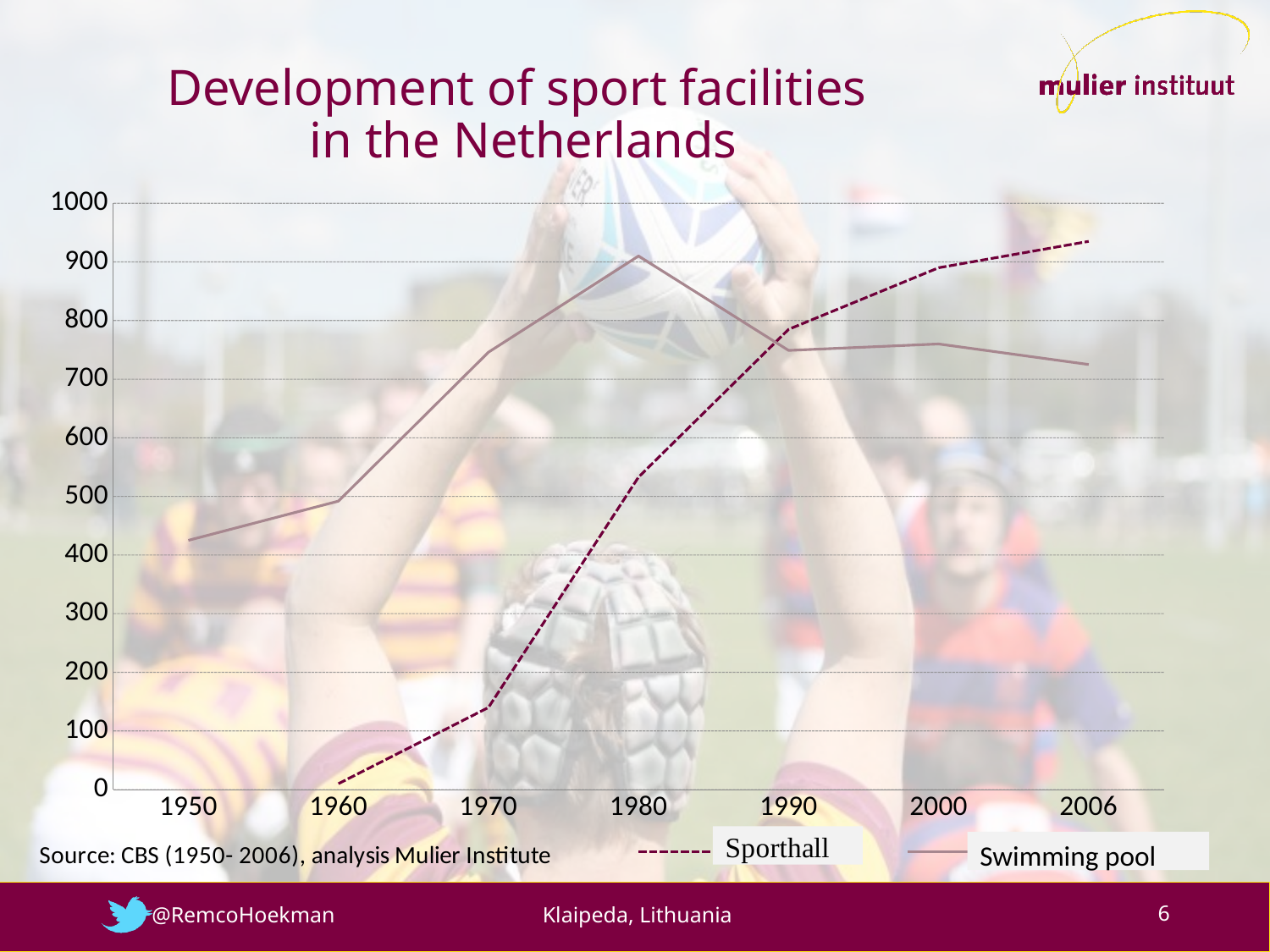
How many series does the legend list? 2 In 2006, which series has the larger value, Sporthall or Swimming pool? Sporthall What kind of chart is shown on the slide? line chart Is the value for Sporthall in 1990 greater or less than 700? greater In which year does the Swimming pool series reach its highest value? 1980 In which year does the Sporthall series reach its highest value? 2006 Is the value for Swimming pool in 1980 greater or less than 800? greater Is the value for Sporthall in 1970 greater or less than 200? less How many years are labelled on the x axis? 7 In 1970, which series has the larger value, Sporthall or Swimming pool? Swimming pool Does the Sporthall series rise or fall from 1960 to 2006? rise In which year is the Swimming pool series at its lowest value? 1950